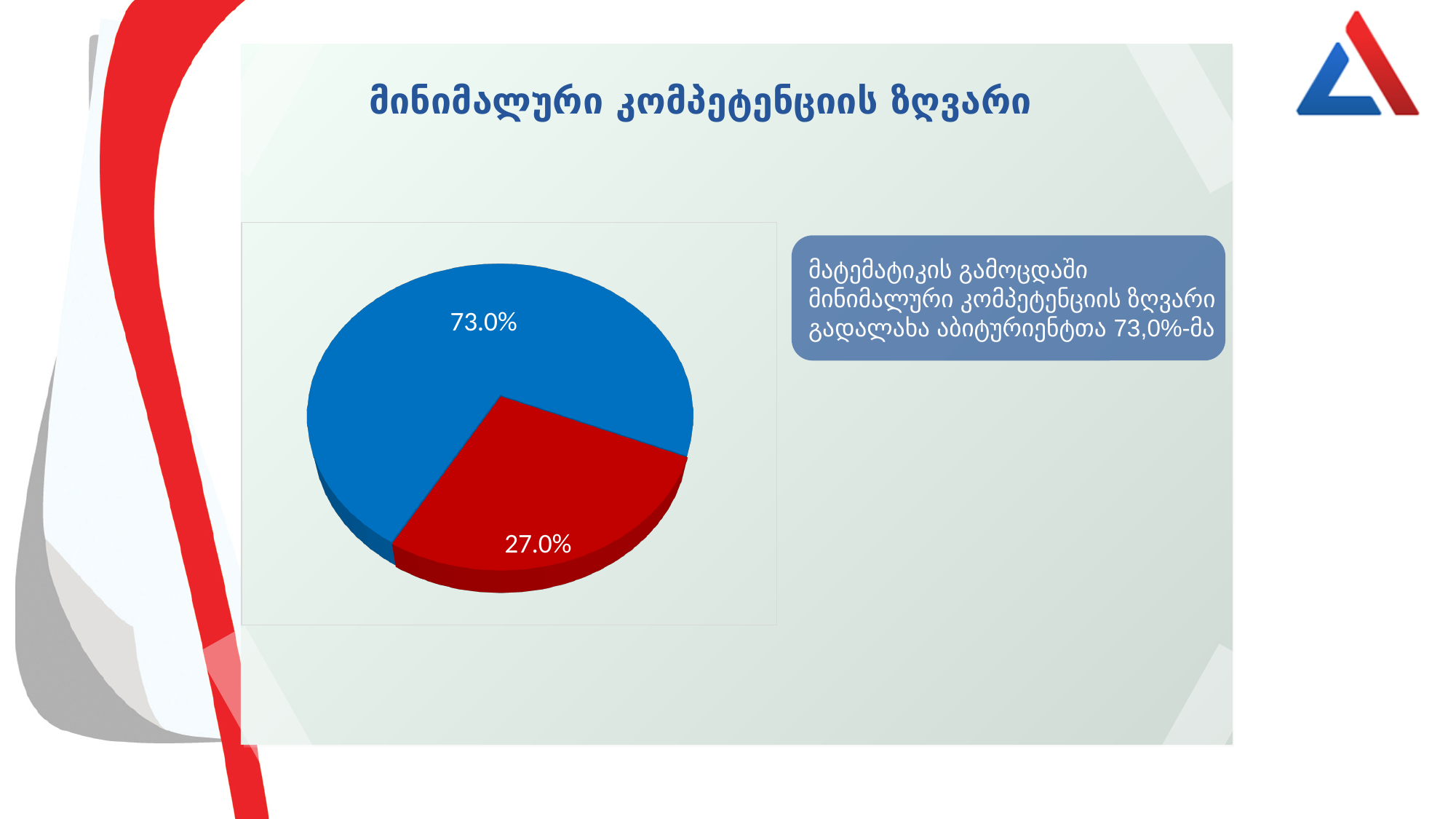
Which slice of the pie chart is the largest? the blue slice (73.0%) Which slice of the pie chart is the smallest? the red slice (27.0%) What is the title of the slide? მინიმალური კომპეტენციის ზღვარი What is the difference between the blue slice and the red slice? 46.0% Which is larger, the blue slice or the red slice? the blue slice What value is shown on the blue slice of the pie chart? 73.0% What do the two slices of the pie chart add up to? 100.0% What value is shown on the red slice of the pie chart? 27.0% Is the value of the red slice greater or less than 50%? less What colour is the slice labelled 27.0%? red What kind of chart is shown on the slide? pie chart How many slices does the pie chart have? 2